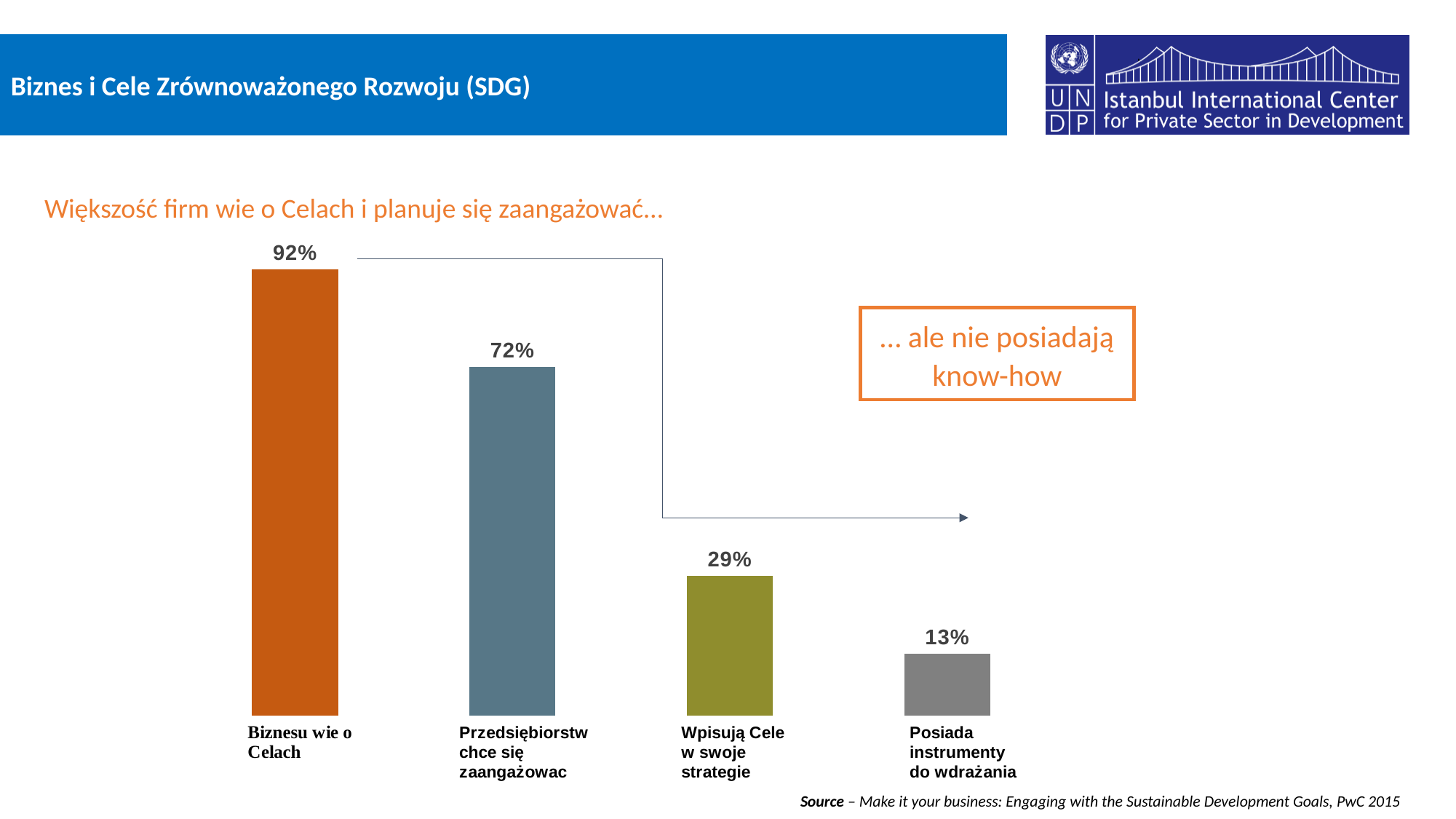
What kind of chart is shown on the slide? Bar chart What value is shown for "Przedsiębiorstw chce się zaangażowac"? 72% What percentage is shown for "Biznesu wie o Celach"? 92% What is the difference between the values for "Wpisują Cele w swoje strategie" and "Posiada instrumenty do wdrażania"? 16% What is the difference between the values for "Biznesu wie o Celach" and "Przedsiębiorstw chce się zaangażowac"? 20% What value is shown for "Posiada instrumenty do wdrażania"? 13% Which is larger: the value for "Przedsiębiorstw chce się zaangażowac" or for "Wpisują Cele w swoje strategie"? Przedsiębiorstw chce się zaangażowac How many bars are shown in the chart? 4 Which category has the highest value? Biznesu wie o Celach What percentage is shown for "Wpisują Cele w swoje strategie"? 29% Which category has the lowest value? Posiada instrumenty do wdrażania Do the values rise or fall from left to right across the bars? Fall